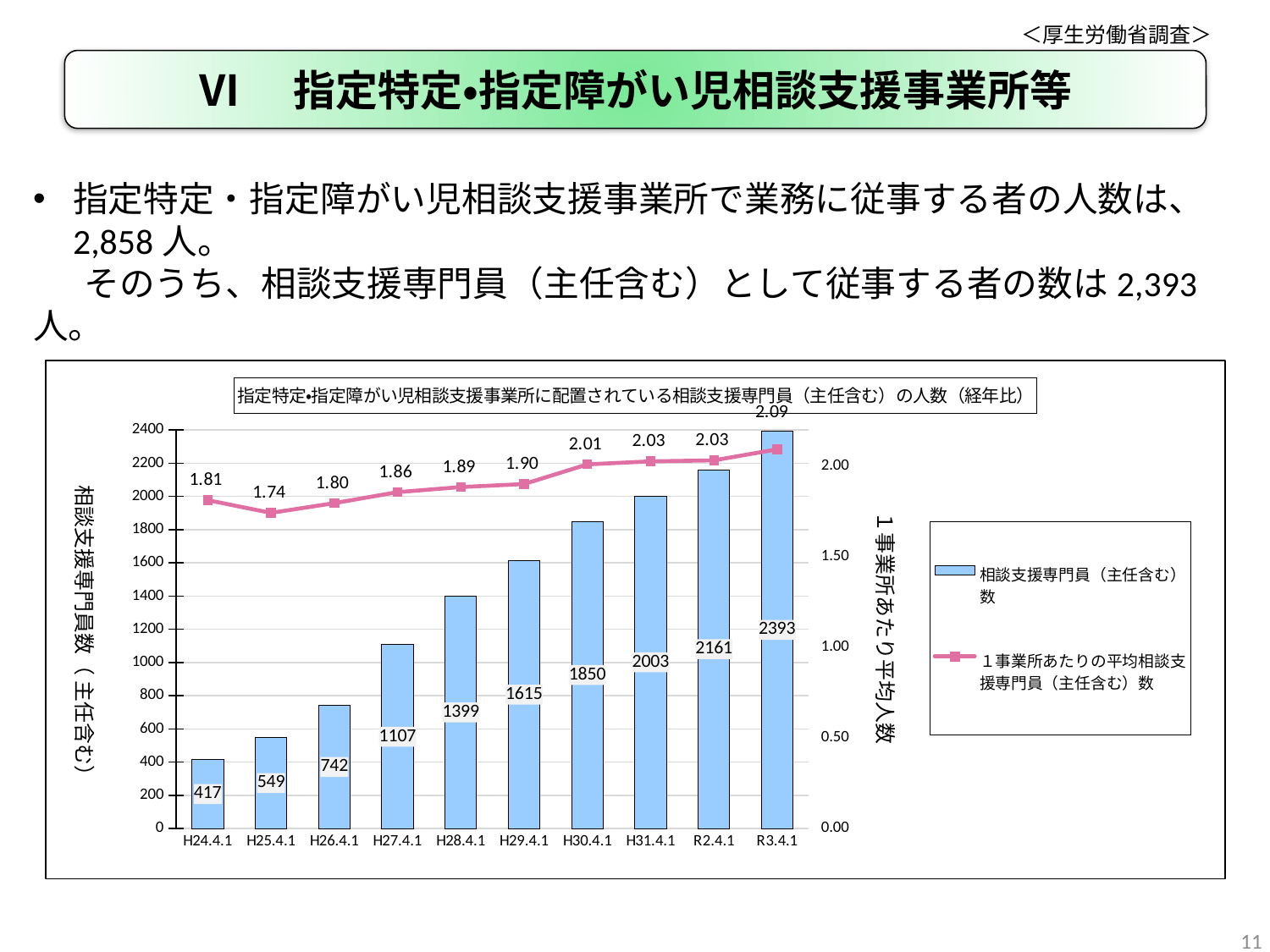
What colour are the bars for 相談支援専門員（主任含む）数? Light blue What is the number of 相談支援専門員（主任含む） at R3.4.1? 2393 How many series does the legend list? 2 Which is larger, the number of 相談支援専門員（主任含む） at H28.4.1 or at H29.4.1? H29.4.1 What kind of chart is shown on the slide? Combined bar and line chart Does the number of 相談支援専門員（主任含む） rise or fall from H24.4.1 to R3.4.1? Rise How many dates are shown on the x axis of the chart? 10 Which date has the lowest value of 1事業所あたりの平均相談支援専門員（主任含む）数? H25.4.1 What is the difference in the number of 相談支援専門員（主任含む） between R2.4.1 and H31.4.1? 158 What is the value of 1事業所あたりの平均相談支援専門員（主任含む）数 at H25.4.1? 1.74 Which date has the highest number of 相談支援専門員（主任含む）? R3.4.1 What is the number of 相談支援専門員（主任含む） at H27.4.1? 1107